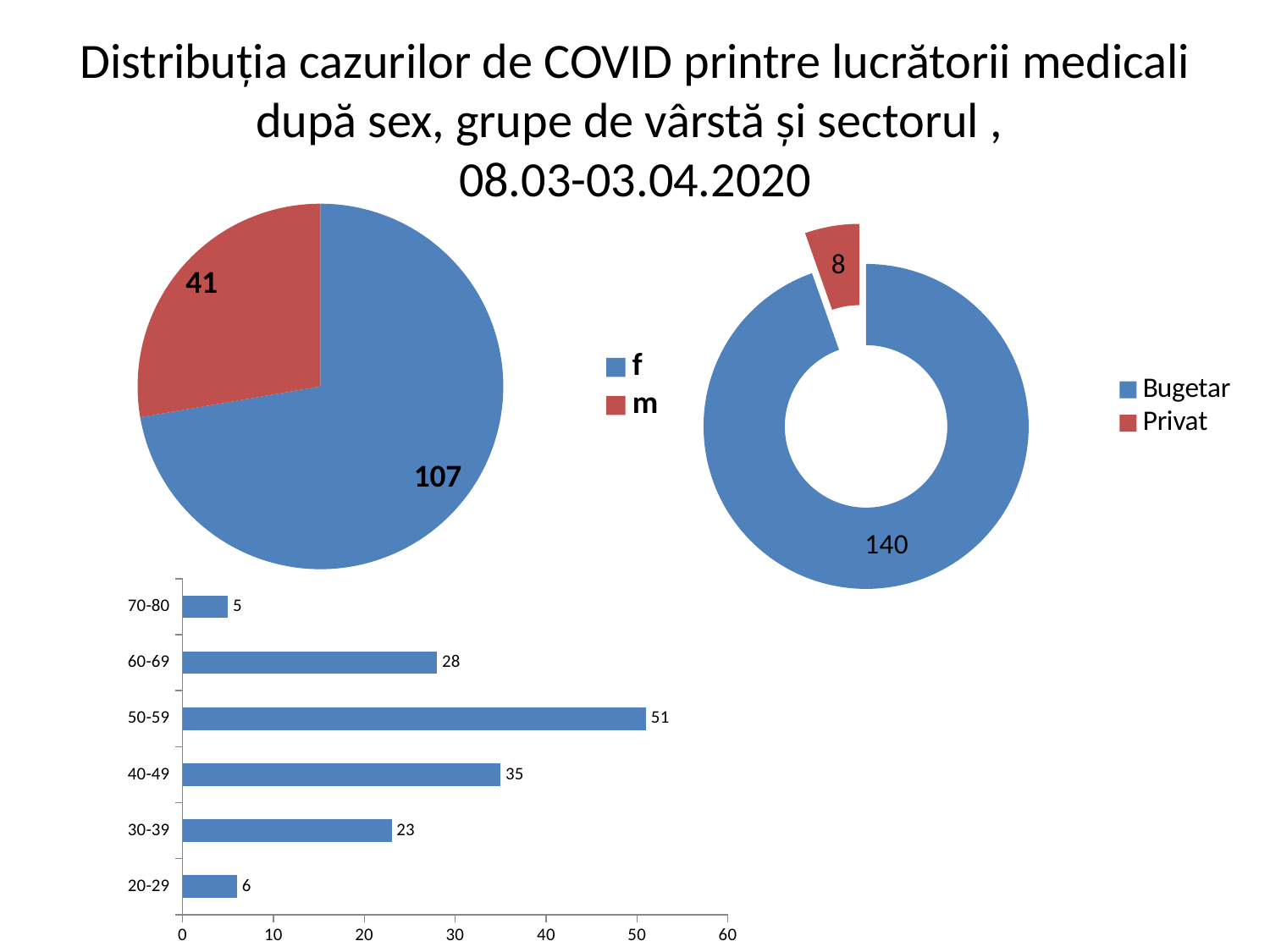
In the bar chart at the bottom, what is the value for the 50-59 age group? 51 In the doughnut chart on the right, what is the value for Bugetar? 140 In the pie chart on the left, what is the value for m? 41 In the bar chart at the bottom, which age group has the highest value? 50-59 In the doughnut chart on the right, which category is larger, Bugetar or Privat? Bugetar What kind of chart is the chart at the bottom of the slide? Bar chart In the pie chart on the left, what is the value for f? 107 In the pie chart on the left, what is the difference between the values for f and m? 66 How many age groups are shown in the bar chart at the bottom? 6 In the doughnut chart on the right, what is the value for Privat? 8 In the bar chart at the bottom, what is the difference between the values for 40-49 and 30-39? 12 In the bar chart at the bottom, which age group has the lowest value? 70-80